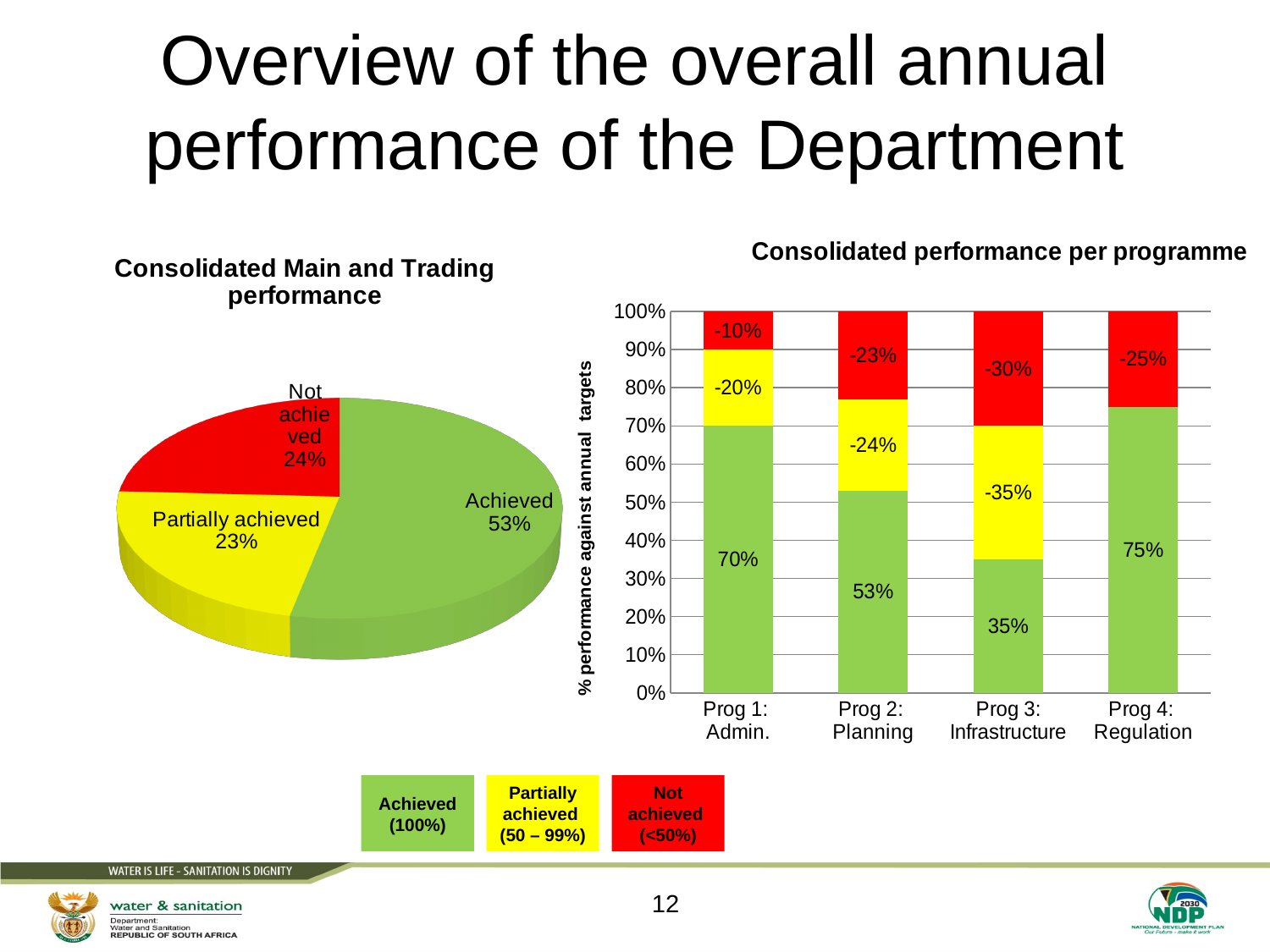
In the 'Consolidated performance per programme' chart, which programme has the highest green (Achieved) value? Prog 4: Regulation In the 'Consolidated performance per programme' chart, which programme has the lowest green (Achieved) value? Prog 3: Infrastructure What kind of chart is the 'Consolidated Main and Trading performance' chart? Pie chart In the 'Consolidated performance per programme' chart, what is the label on the red segment for Prog 2: Planning? -23% In the 'Consolidated Main and Trading performance' chart, how many slices does the pie have? 3 In the 'Consolidated Main and Trading performance' chart, which slice is the largest? Achieved In the 'Consolidated Main and Trading performance' chart, what is the value for Partially achieved? 23% In the 'Consolidated performance per programme' chart, what is the green (Achieved) value for Prog 3: Infrastructure? 35% In the 'Consolidated performance per programme' chart, how many programmes are shown on the x axis? 4 What kind of chart is the 'Consolidated performance per programme' chart? Stacked bar chart In the 'Consolidated performance per programme' chart, what is the difference between the green values for Prog 1: Admin. and Prog 2: Planning? 17% In the 'Consolidated Main and Trading performance' chart, what share of the pie is labelled Achieved? 53%